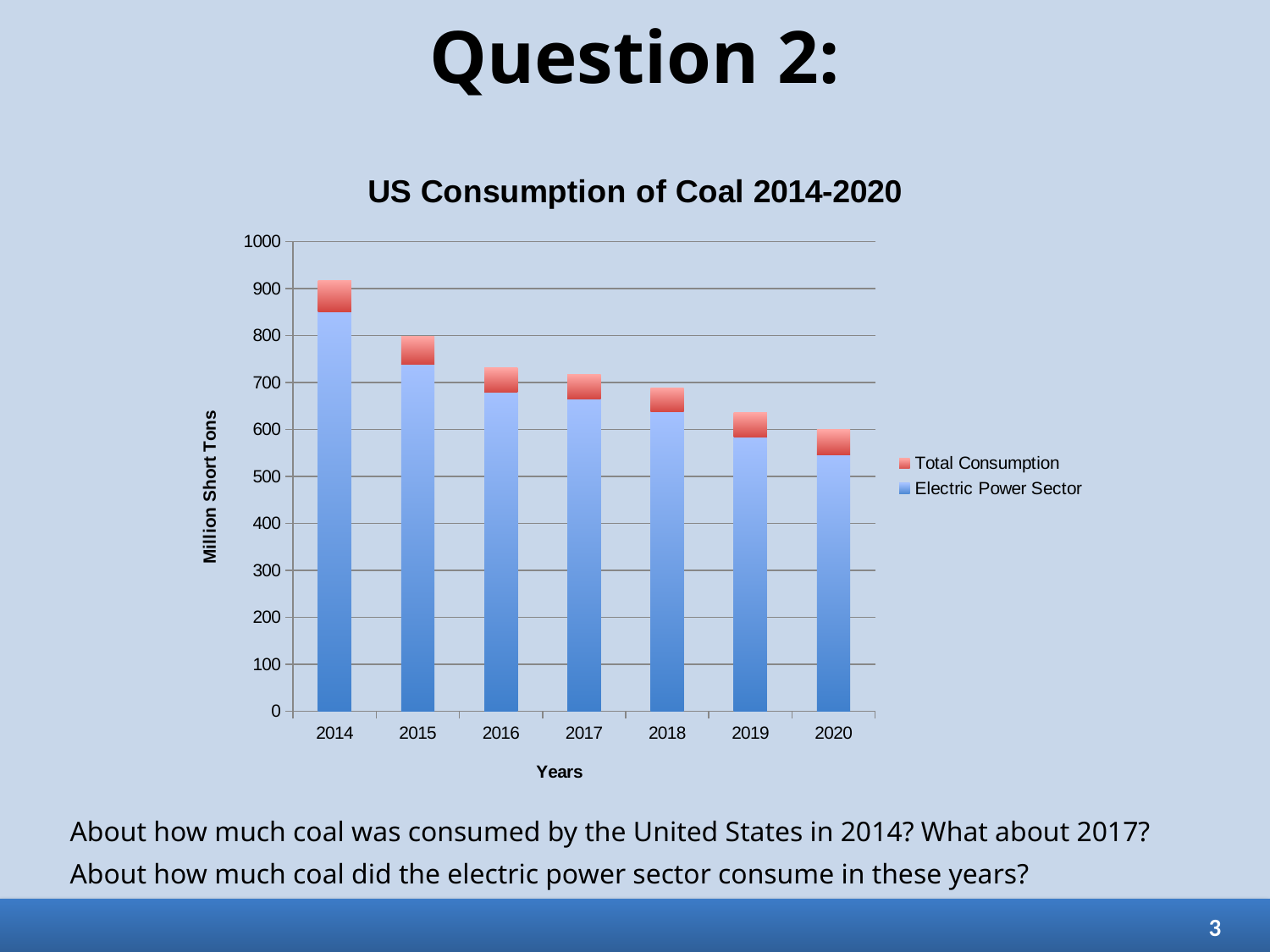
Which year has the tallest bar? 2014 Is the Electric Power Sector value for 2020 greater or less than 600? less What is the title of the chart? US Consumption of Coal 2014-2020 Is the Electric Power Sector value for 2018 greater or less than 600? greater Is the Electric Power Sector value for 2014 greater or less than 800? greater How many series does the legend list? 2 What kind of chart is shown on the slide? bar chart Which year has the shortest bar? 2020 Which year has the larger Electric Power Sector value, 2015 or 2018? 2015 What is the label on the vertical axis? Million Short Tons Do the bars rise or fall from 2014 to 2020? fall How many years are shown on the x axis? 7